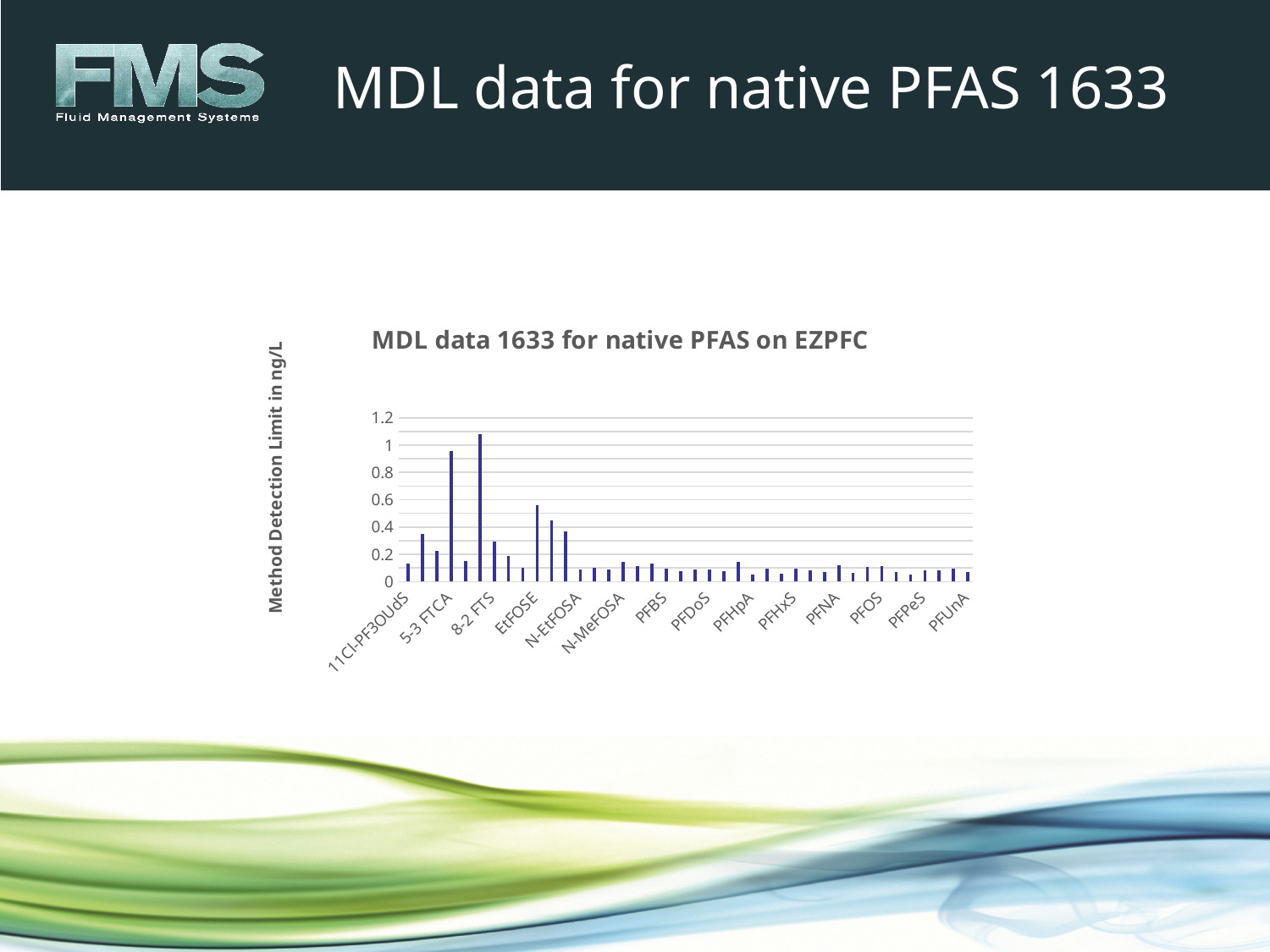
What is the label of the vertical axis of the chart? Method Detection Limit in ng/L Is the tallest bar in the chart greater or less than 1? greater What is the title of the chart? MDL data 1633 for native PFAS on EZPFC Is the value for 11Cl-PF3OUdS, the first bar, greater or less than 0.2? less What kind of chart is shown on the slide? bar chart What is the highest tick value shown on the vertical axis? 1.2 What is the interval between consecutive tick marks on the vertical axis? 0.2 Is the tallest bar in the chart greater or less than 1.2? less Which is larger, the value for the first bar (11Cl-PF3OUdS) or the tallest bar in the chart? the tallest bar